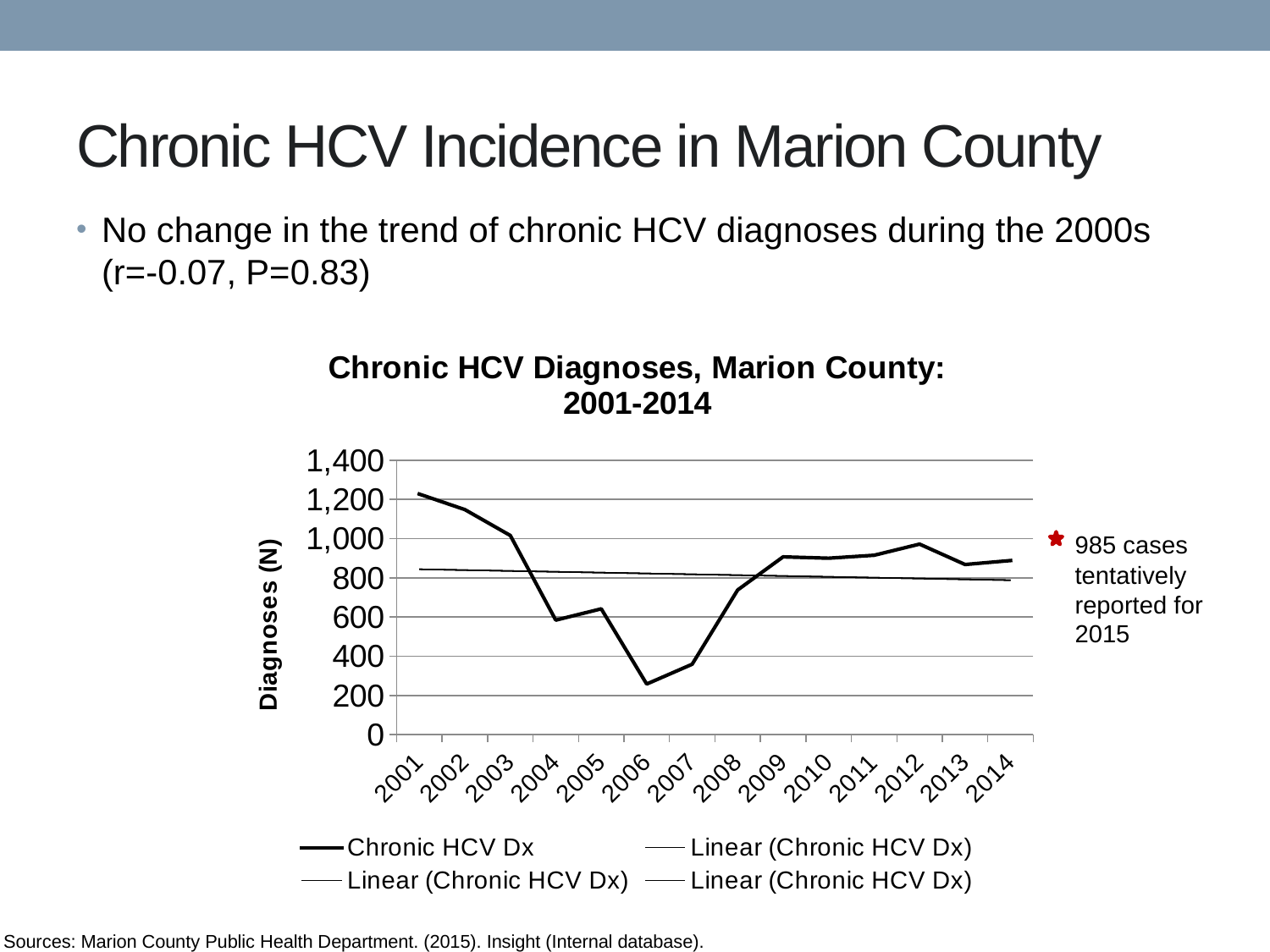
Which year has the highest number of chronic HCV diagnoses? 2001 Is the value for Chronic HCV Dx in 2001 greater or less than 1,200? greater What kind of chart is shown on the slide? Line chart Do chronic HCV diagnoses rise or fall from 2001 to 2006? Fall Which year has the lowest number of chronic HCV diagnoses? 2006 Is the value for Chronic HCV Dx in 2012 greater or less than 800? greater What is the label of the y axis? Diagnoses (N) How many years are plotted along the x axis of the chart? 14 What is the title of the chart? Chronic HCV Diagnoses, Marion County: 2001-2014 How many entries does the chart's legend list? 4 Which year has more chronic HCV diagnoses, 2004 or 2009? 2009 Is the value for Chronic HCV Dx in 2006 greater or less than 400? less